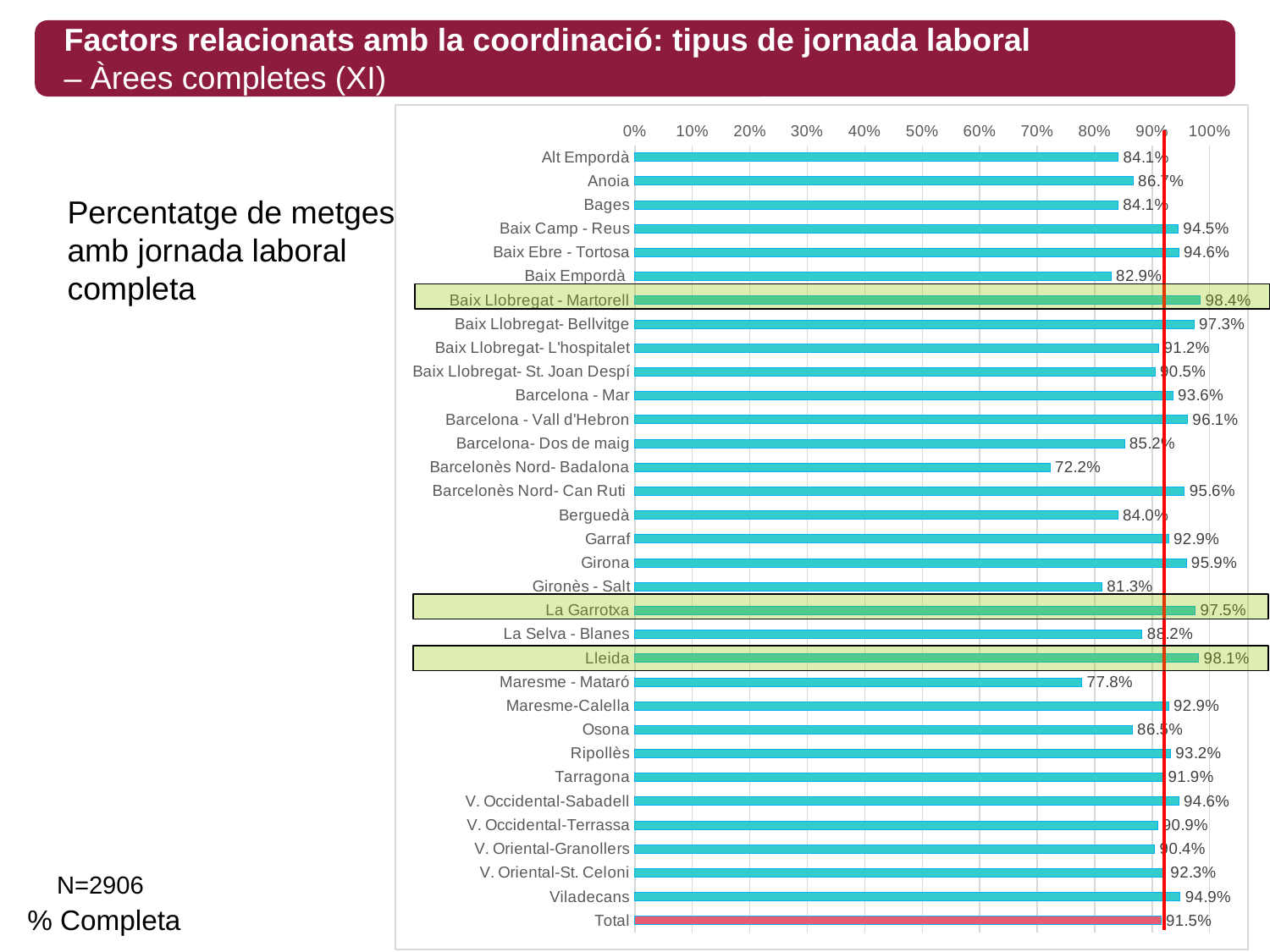
What is the value for Barcelonès Nord- Badalona? 72.2% What type of chart is shown on the slide? bar chart Which three areas are highlighted with a green box in the chart? Baix Llobregat - Martorell, La Garrotxa, Lleida What is the value for Maresme - Mataró? 77.8% What is the value for Total? 91.5% What is the value for Lleida? 98.1% Which area has the highest percentage? Baix Llobregat - Martorell Which is larger, the value for La Garrotxa or the value for Girona? La Garrotxa What is the difference between the values for Baix Llobregat - Martorell and Barcelonès Nord- Badalona? 26.2% How many bars are plotted in the chart, including Total? 33 Is the value for Gironès - Salt greater or less than 90%? less Which area has the lowest percentage? Barcelonès Nord- Badalona